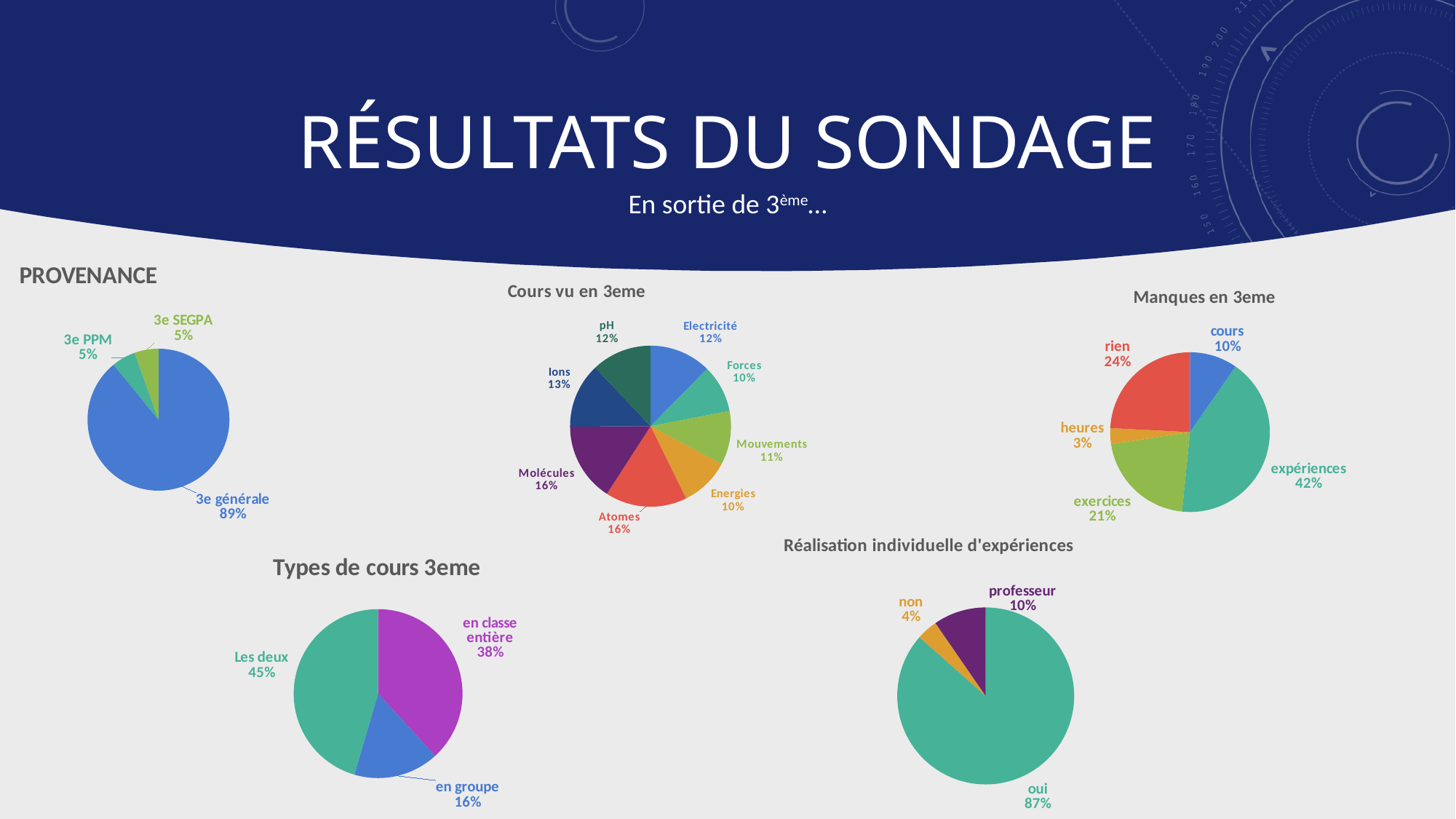
In the Cours vu en 3eme chart, what is the difference between Ions and Forces? 3% In the PROVENANCE chart, how many slices does the pie have? 3 In the PROVENANCE chart, what share of the pie is 3e générale? 89% What type of chart is the Réalisation individuelle d'expériences chart? pie chart In the Types de cours 3eme chart, which is larger, Les deux or en classe entière? Les deux In the Cours vu en 3eme chart, what is the value for Molécules? 16% In the Types de cours 3eme chart, what is the value for en groupe? 16% In the Réalisation individuelle d'expériences chart, what share of the pie is oui? 87% In the Manques en 3eme chart, which category has the smallest share? heures In the Cours vu en 3eme chart, how many categories are shown? 8 In the Manques en 3eme chart, what is the difference between rien and exercices? 3% In the Manques en 3eme chart, which category has the largest share? expériences